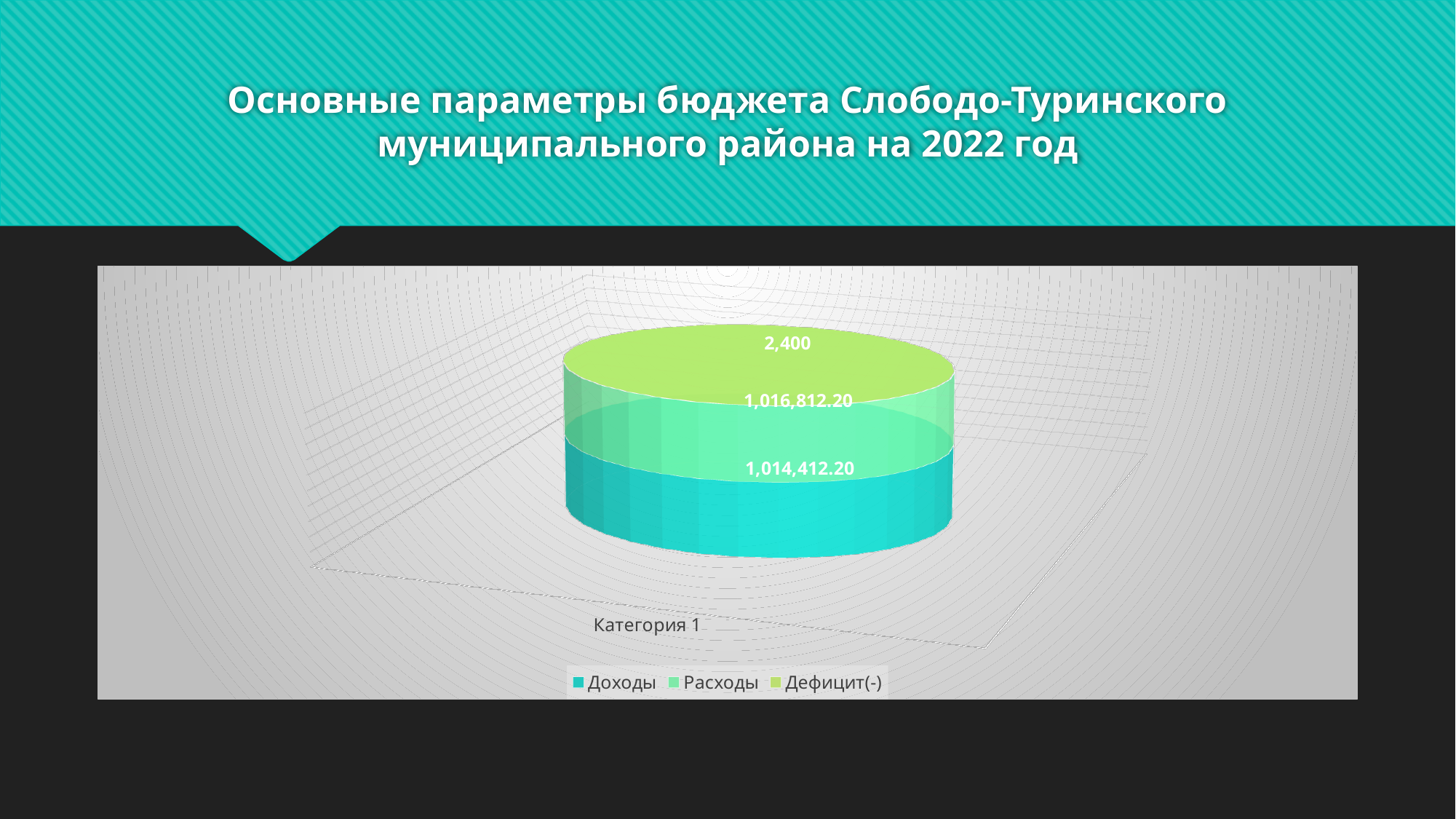
How many categories are shown on the x axis? 1 What kind of chart is shown on the slide? Stacked bar chart Which is larger, Расходы or Доходы? Расходы What is the difference between Расходы and Доходы? 2,400.00 Which series has the smallest value? Дефицит(-) What is the title of the slide? Основные параметры бюджета Слободо-Туринского муниципального района на 2022 год How many series does the legend list? 3 What is the name of the only category on the x axis? Категория 1 What is the value for Доходы? 1,014,412.20 What is the value for Расходы? 1,016,812.20 What is the value for Дефицит(-)? 2,400 Which series has the largest value? Расходы